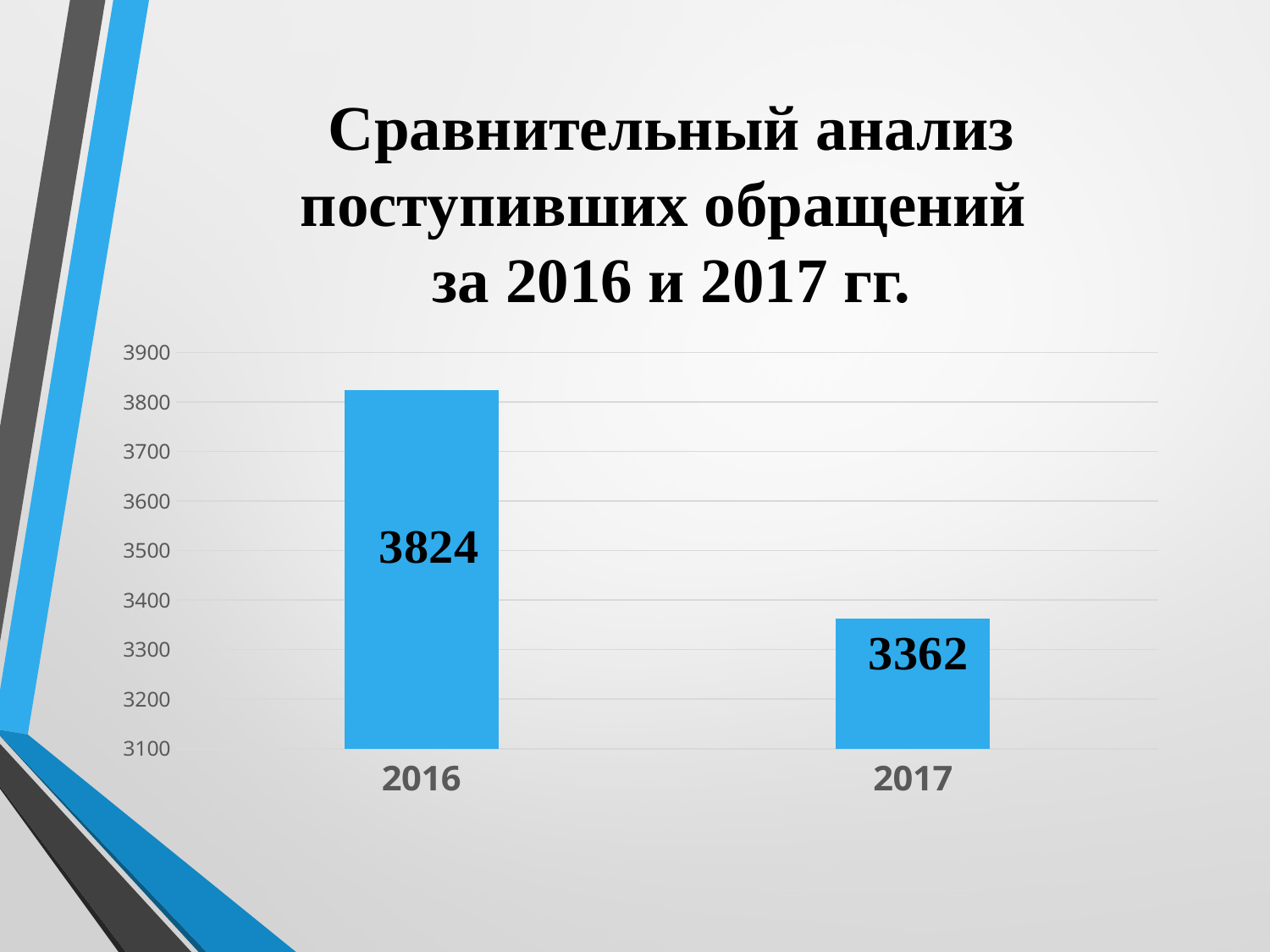
Is the value for 2017 greater or less than 3400? less What is the value for 2017? 3362 What is the title of the slide? Сравнительный анализ поступивших обращений за 2016 и 2017 гг. Which year has the lowest value? 2017 How many categories are shown on the x axis? 2 Which is larger, the value for 2016 or the value for 2017? 2016 What is the value for 2016? 3824 What kind of chart is shown on the slide? bar chart What is the difference between the values for 2016 and 2017? 462 Which year has the highest value? 2016 Is the value for 2016 greater or less than 3700? greater Do the values rise or fall from 2016 to 2017? fall